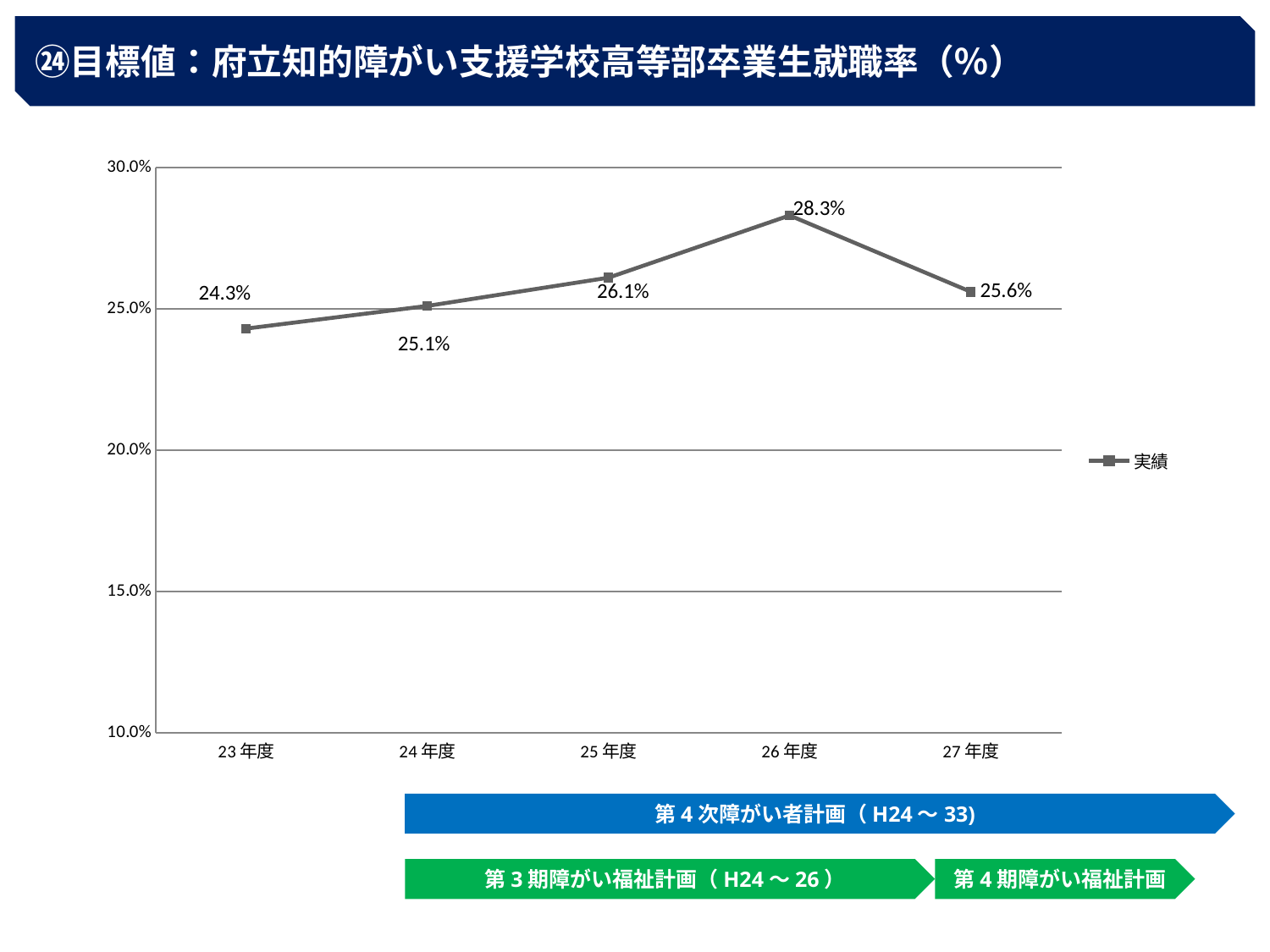
What is the value for 27年度? 25.6% Which year has the lowest value? 23年度 What is the difference between the values for 26年度 and 27年度? 2.7% What is the value for 23年度? 24.3% What is the difference between the values for 25年度 and 24年度? 1.0% Is the value for 26年度 greater or less than 25.0%? greater How many series does the legend list? 1 Which year has the highest value? 26年度 Which is larger, the value for 25年度 or the value for 27年度? 25年度 What kind of chart is shown? line chart What is the value for 26年度? 28.3% How many years are plotted on the x axis? 5